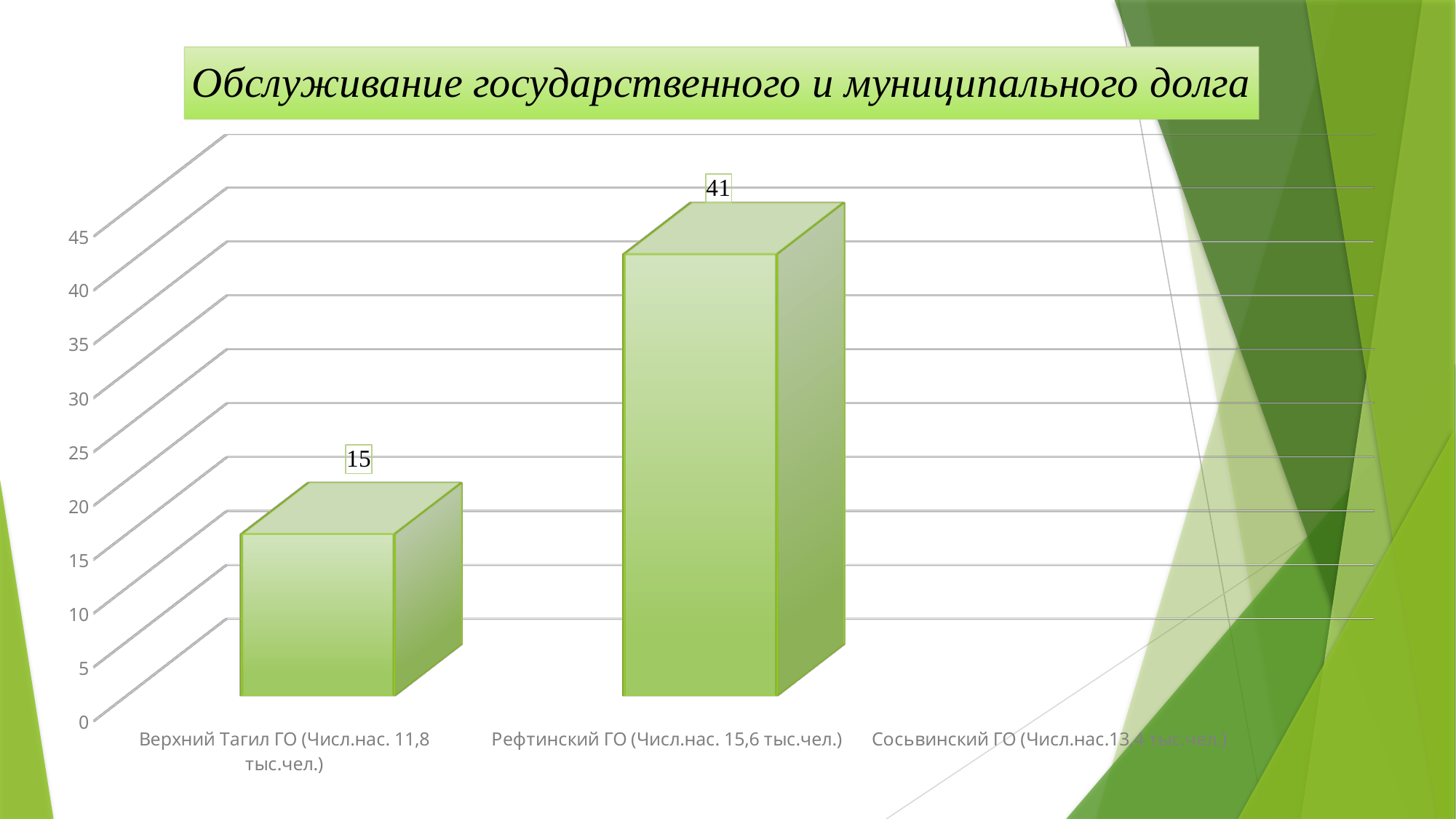
Is the value for Верхний Тагил ГО greater or less than 20? less Which is larger, the value for Верхний Тагил ГО or the value for Рефтинский ГО? Рефтинский ГО What is the value shown for Верхний Тагил ГО? 15 What kind of chart is shown on the slide? bar chart What is the title of the slide? Обслуживание государственного и муниципального долга What is the highest value shown on the vertical axis? 45 What is the value shown for Рефтинский ГО? 41 Is the value for Рефтинский ГО greater or less than 40? greater Which category has the highest bar? Рефтинский ГО Which labeled category has no visible bar? Сосьвинский ГО What is the difference between the values for Рефтинский ГО and Верхний Тагил ГО? 26 How many categories are labeled on the x axis? 3